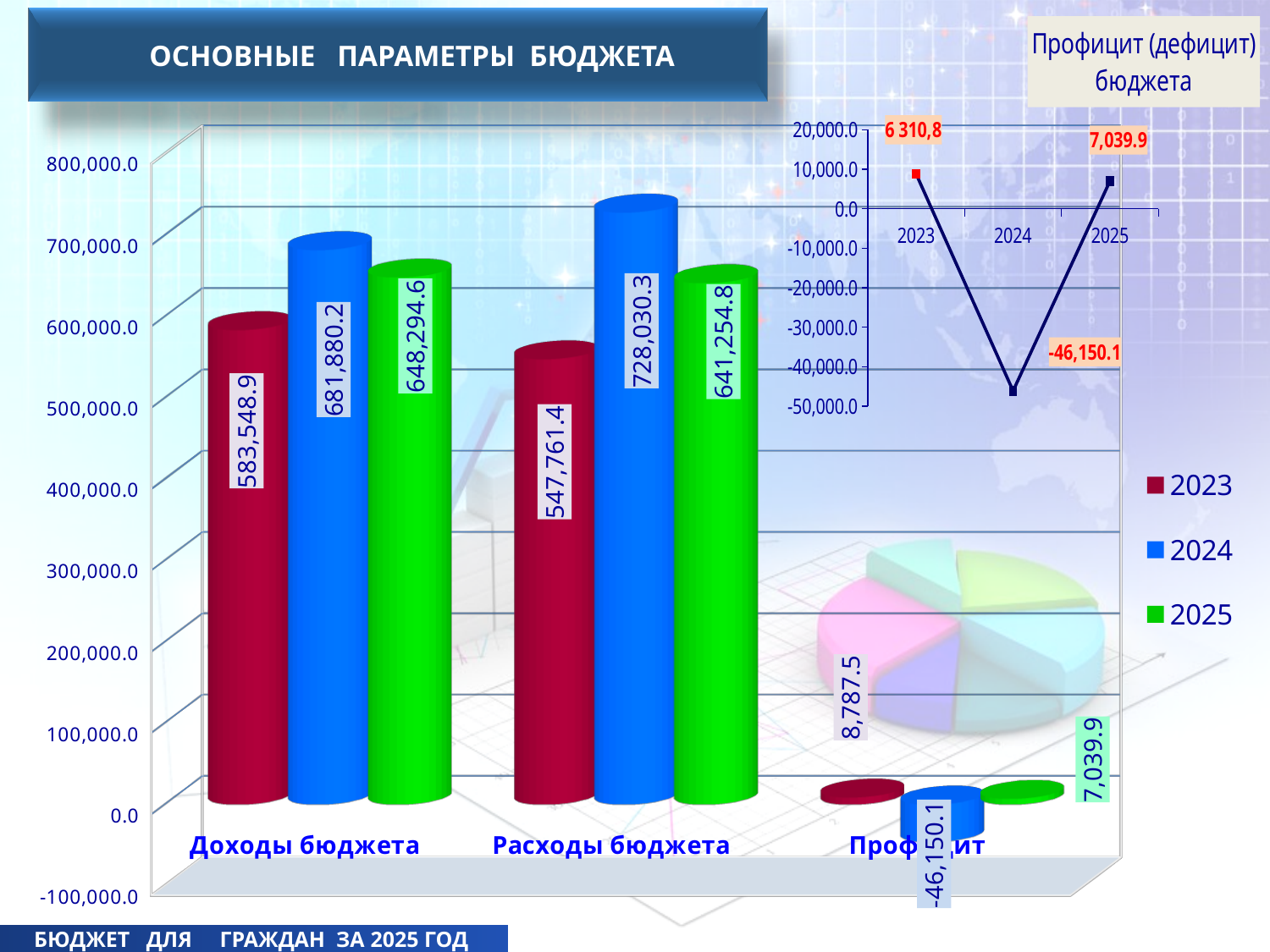
What kind of chart is 'Профицит (дефицит) бюджета'? Line chart In the chart 'Профицит (дефицит) бюджета', which year has the lowest value? 2024 In the bar chart 'ОСНОВНЫЕ ПАРАМЕТРЫ БЮДЖЕТА', what is the value for Доходы бюджета in 2024? 681,880.2 In the bar chart 'ОСНОВНЫЕ ПАРАМЕТРЫ БЮДЖЕТА', what is the value for Расходы бюджета in 2025? 641,254.8 In the bar chart 'ОСНОВНЫЕ ПАРАМЕТРЫ БЮДЖЕТА', which year has the lowest value for Доходы бюджета? 2023 In the chart 'Профицит (дефицит) бюджета', what is the value for 2024? -46,150.1 In the bar chart 'ОСНОВНЫЕ ПАРАМЕТРЫ БЮДЖЕТА', which is larger: Доходы бюджета in 2025 or Расходы бюджета in 2025? Доходы бюджета in 2025 In the bar chart 'ОСНОВНЫЕ ПАРАМЕТРЫ БЮДЖЕТА', which year has the highest value for Расходы бюджета? 2024 In the bar chart 'ОСНОВНЫЕ ПАРАМЕТРЫ БЮДЖЕТА', how many series does the legend list? 3 In the bar chart 'ОСНОВНЫЕ ПАРАМЕТРЫ БЮДЖЕТА', what is the value for Профицит in 2024? -46,150.1 In the bar chart 'ОСНОВНЫЕ ПАРАМЕТРЫ БЮДЖЕТА', what is the difference between Расходы бюджета in 2024 and in 2023? 180,268.9 In the bar chart 'ОСНОВНЫЕ ПАРАМЕТРЫ БЮДЖЕТА', how many categories are shown on the x axis? 3